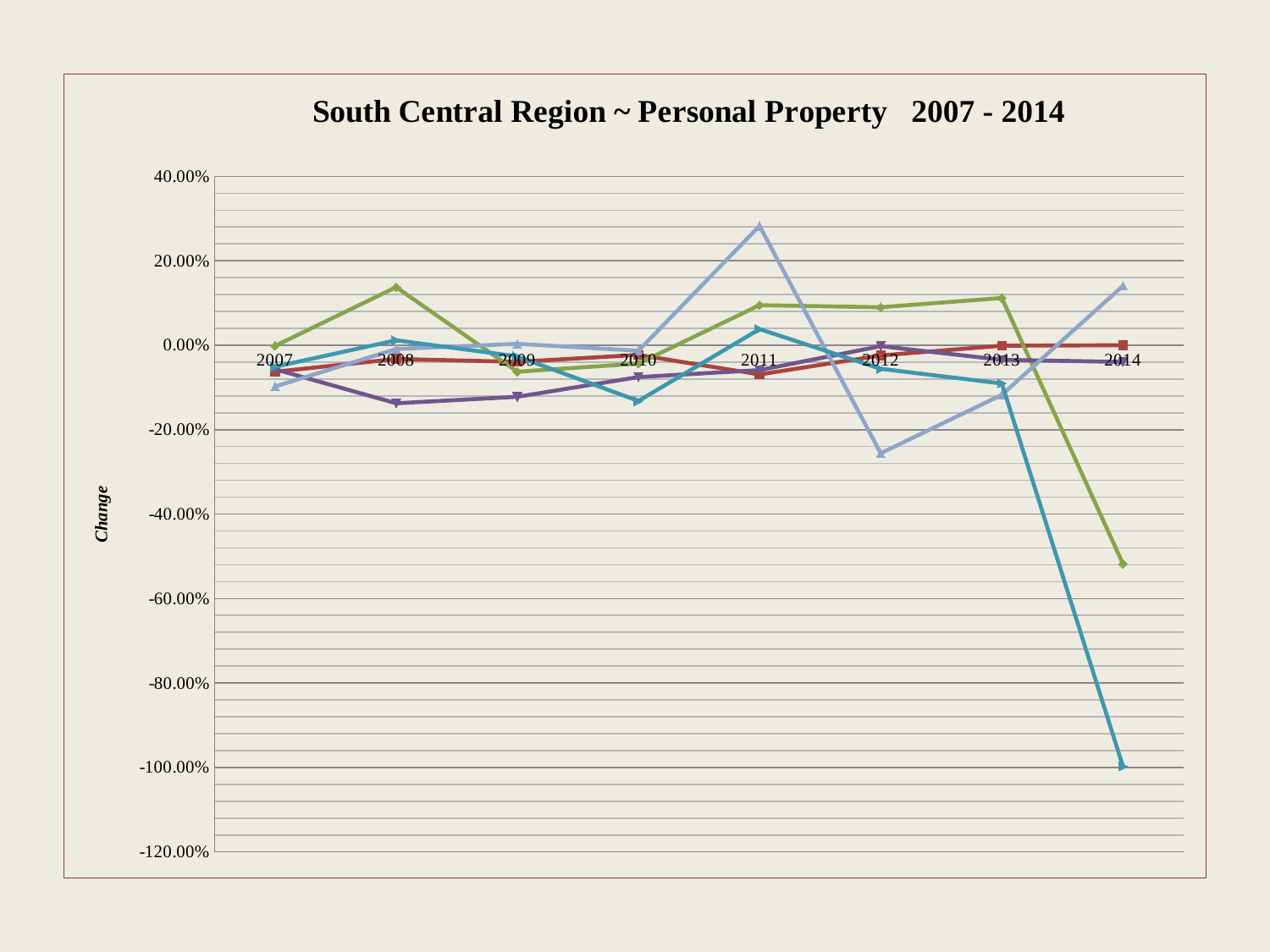
Is the value of the light blue line in 2012 greater or less than -20.00%? less Is the value of the light blue line in 2011 greater or less than 20.00%? greater How many years are shown along the x axis of the chart? 8 How many lines are plotted on the chart? 5 What kind of chart is shown on the slide? line chart What is the title of the chart? South Central Region ~ Personal Property 2007 - 2014 Is the value of the green line in 2014 greater or less than -40.00%? less What is the label on the vertical axis of the chart? Change In 2014, which line has the higher value, the green line or the teal line? green line In which year does the teal line reach its lowest value? 2014 In which year does the light blue line reach its highest value? 2011